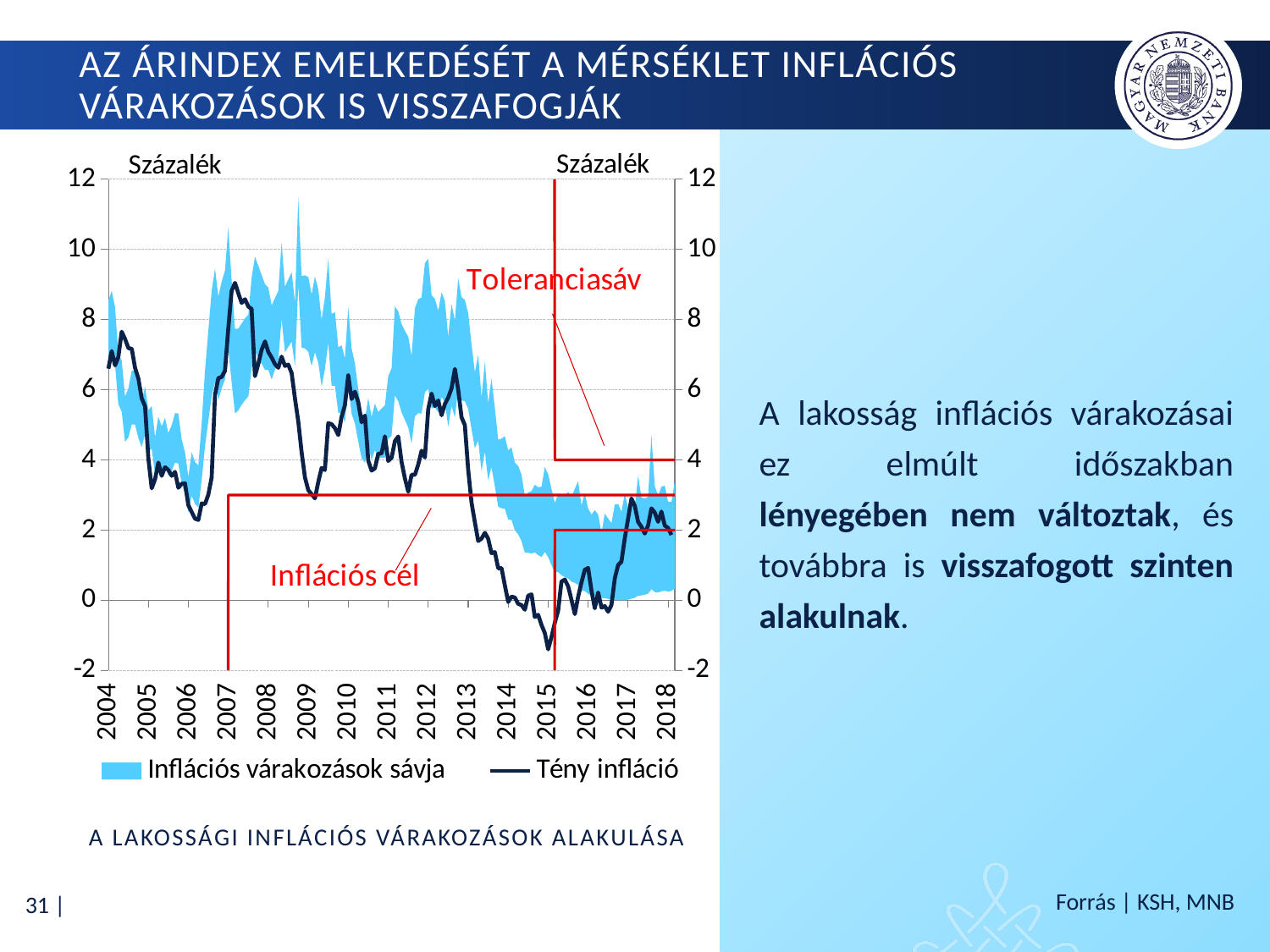
Is the value of Tény inflació at the start of 2004 greater or less than 6? greater Does Tény inflació rise or fall between 2006 and 2007? rise How many series does the chart legend list? 2 Between which two values does the Toleranciasáv lie on the chart from 2015 onwards? 2 and 4 Does Tény inflació rise or fall between 2013 and 2015? fall How many years are labelled on the x axis of the chart? 15 Is the value of Tény inflació at the start of 2015 greater or less than 2? less What are the two entries in the chart legend? Inflációs várakozások sávja; Tény infláció What kind of chart is shown on the slide? combination area and line chart Is the value of Tény inflació at the start of 2008 greater or less than 4? greater At what level is the Inflációs cél line drawn on the chart from 2007 onwards? 3 What unit is shown on the vertical axes of the chart? Százalék